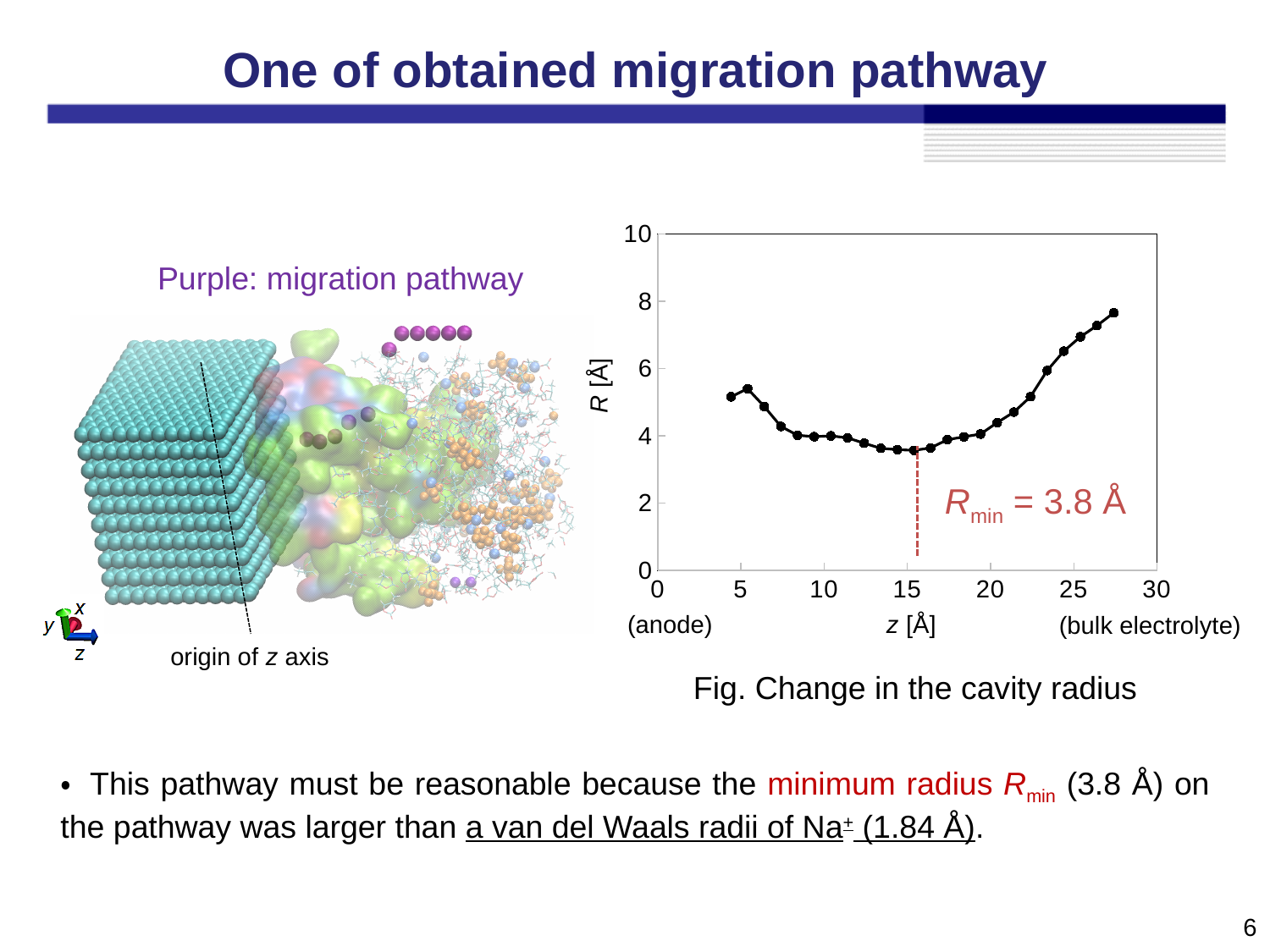
What is the label of the vertical axis of the chart? R [Å] Is the value of R at z = 5 Å greater or less than 6? less Which is larger, the value of R at z = 25 Å or at z = 10 Å? z = 25 Å What is the minimum cavity radius R_min marked on the chart? 3.8 Å Does R rise or fall as z increases from 5 Å to 15 Å? fall Does R rise or fall as z increases from 15 Å to 27 Å? rise What kind of chart is shown on the slide? line chart Is the value of R at z = 5 Å greater or less than 4? greater Is the value of R at z = 15 Å greater or less than 4? less How many data series are plotted on the chart? 1